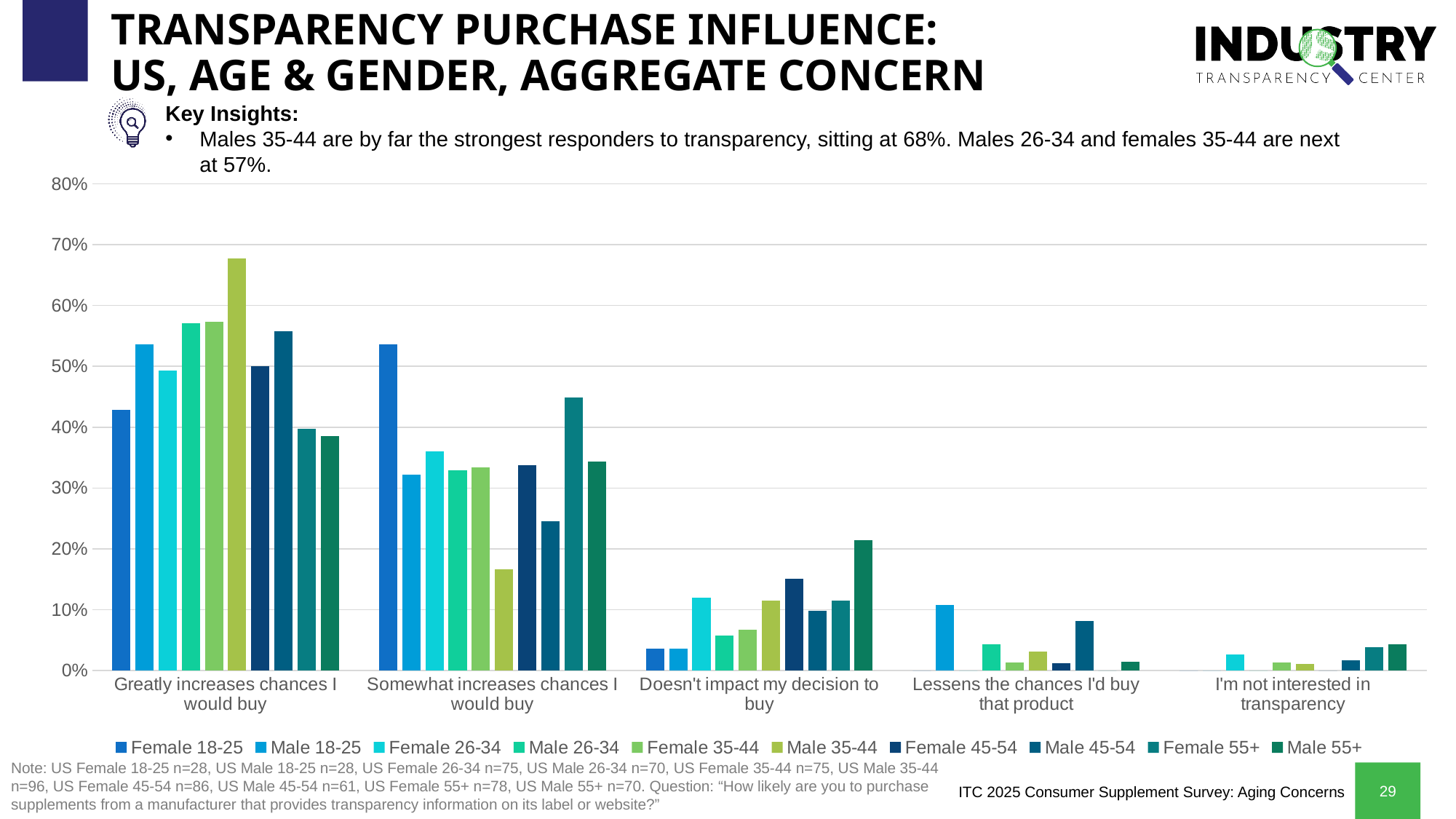
What kind of chart is shown on the slide? Bar chart Do the Male 35-44 bars rise or fall moving from left to right across the categories? fall How many series does the legend list? 10 In the 'Somewhat increases chances I would buy' category, which is larger: Female 18-25 or Male 18-25? Female 18-25 Is the value for Female 18-25 in the 'Greatly increases chances I would buy' category greater or less than 40%? greater According to the slide, what is the value for Male 35-44 in the 'Greatly increases chances I would buy' category? 68% How many response categories are shown along the x axis? 5 In the 'Lessens the chances I'd buy that product' category, which series has the highest bar? Male 18-25 In the 'Doesn't impact my decision to buy' category, which series has the highest bar? Male 55+ In the 'Greatly increases chances I would buy' category, which series has the highest bar? Male 35-44 Is the value for Male 35-44 in the 'Somewhat increases chances I would buy' category greater or less than 20%? less In the 'Somewhat increases chances I would buy' category, which is larger: Female 55+ or Male 55+? Female 55+